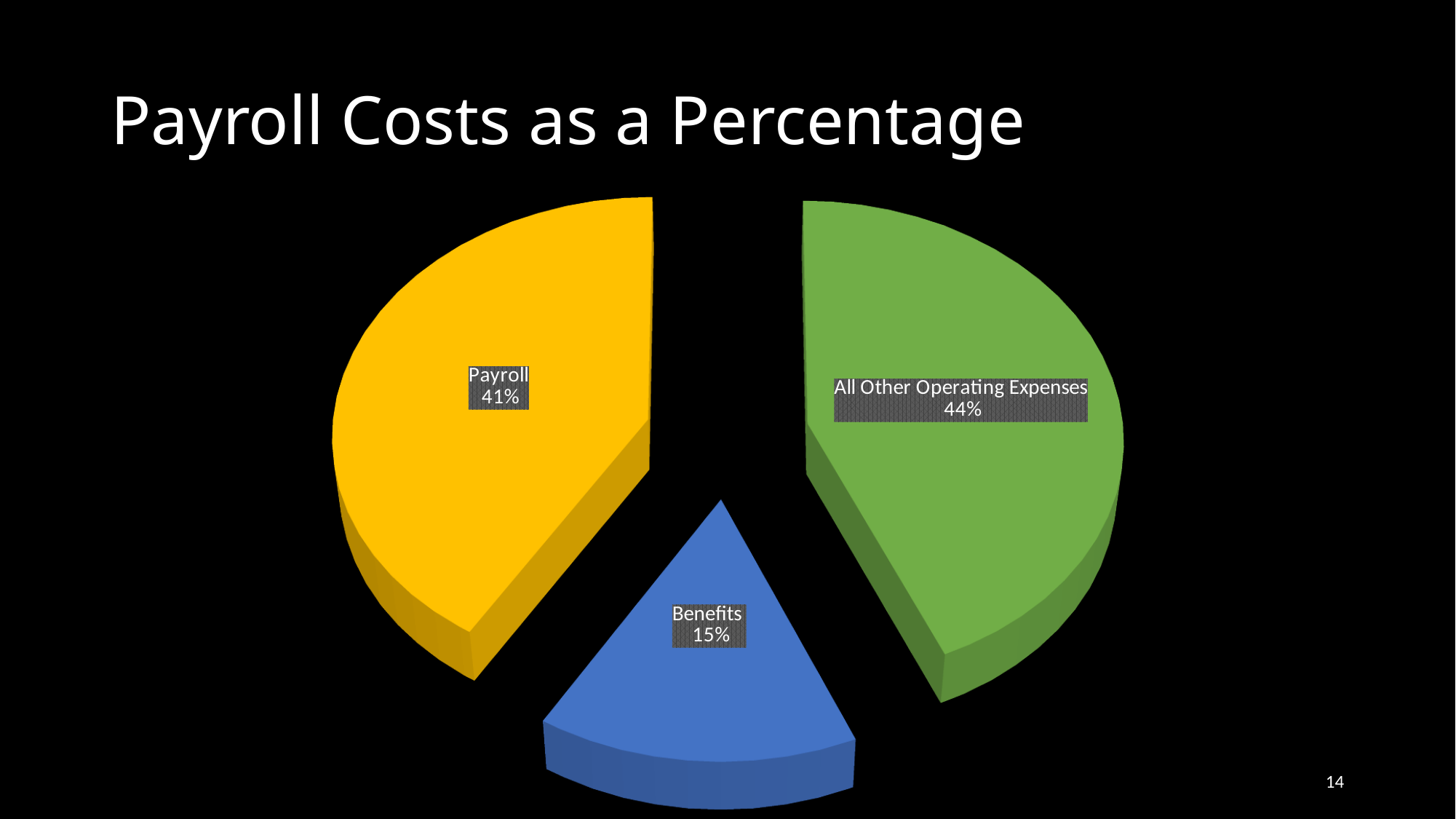
Which slice of the pie is the smallest? Benefits What is the combined share of Payroll and Benefits? 56% What percentage of the pie is Benefits? 15% Which is larger, Payroll or Benefits? Payroll What percentage of the pie is Payroll? 41% Which slice of the pie is the largest? All Other Operating Expenses What is the difference in percentage points between Payroll and Benefits? 26 What colour is the Benefits slice? blue What is the difference in percentage points between All Other Operating Expenses and Payroll? 3 What kind of chart is shown on the slide? pie chart How many slices does the pie chart have? 3 What percentage of the pie is All Other Operating Expenses? 44%